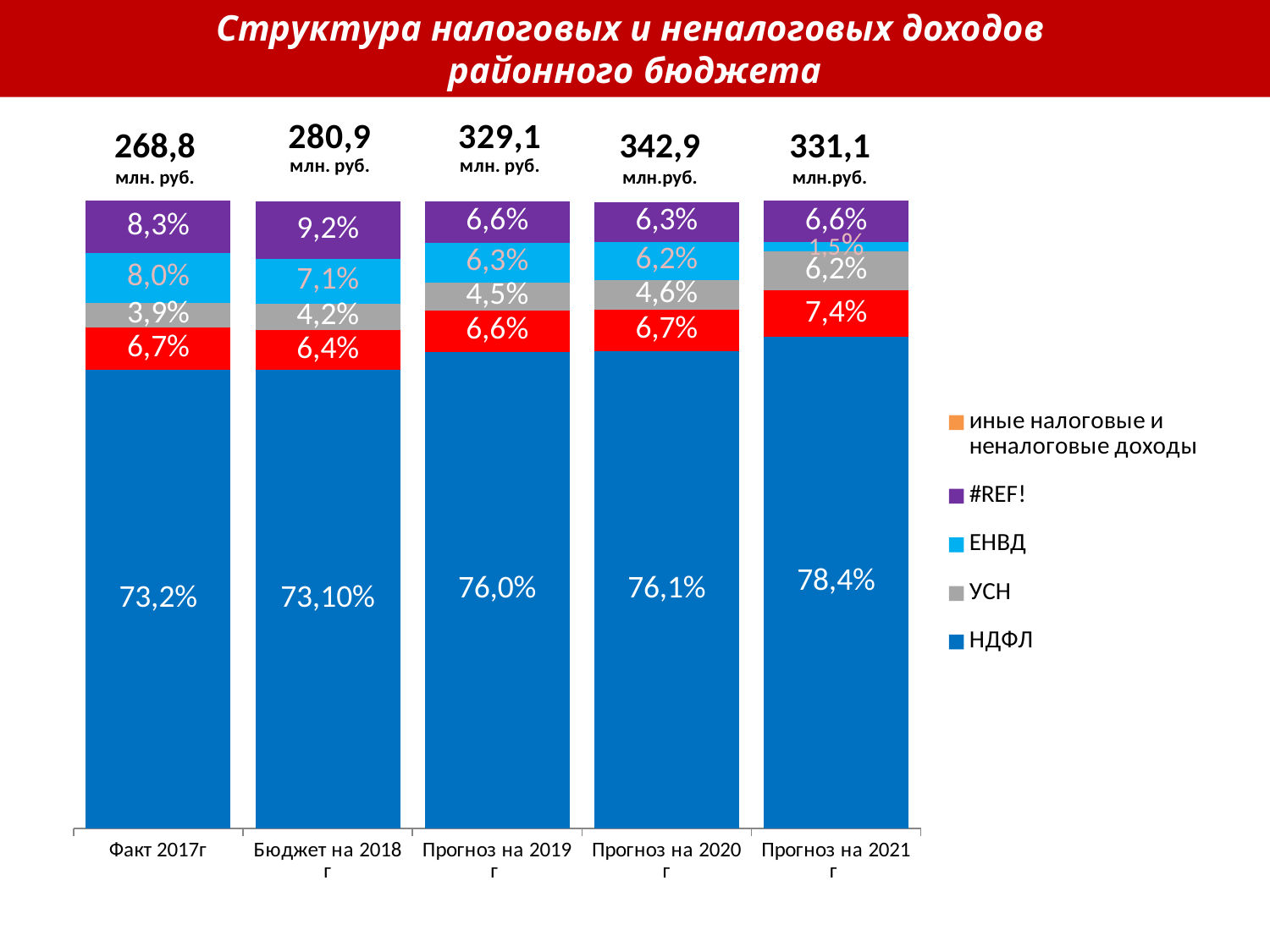
What is the НДФЛ share for Прогноз на 2021 г? 78,4% How many series does the legend list? 5 What is the ЕНВД share for Бюджет на 2018 г? 7,1% Does the УСН share rise or fall from Факт 2017г to Прогноз на 2021 г? Rises What total amount in млн.руб. is printed above the bar for Прогноз на 2020 г? 342,9 млн.руб. How many categories are shown along the x axis of the chart? 5 What kind of chart is shown on the slide? Stacked bar chart Which category has the highest НДФЛ share? Прогноз на 2021 г What is the УСН share for Факт 2017г? 3,9% Which is larger: the ЕНВД share for Факт 2017г or for Прогноз на 2021 г? Факт 2017г By how many percentage points is the НДФЛ share for Прогноз на 2021 г higher than for Факт 2017г? 5,2% Which category has the lowest НДФЛ share? Бюджет на 2018 г